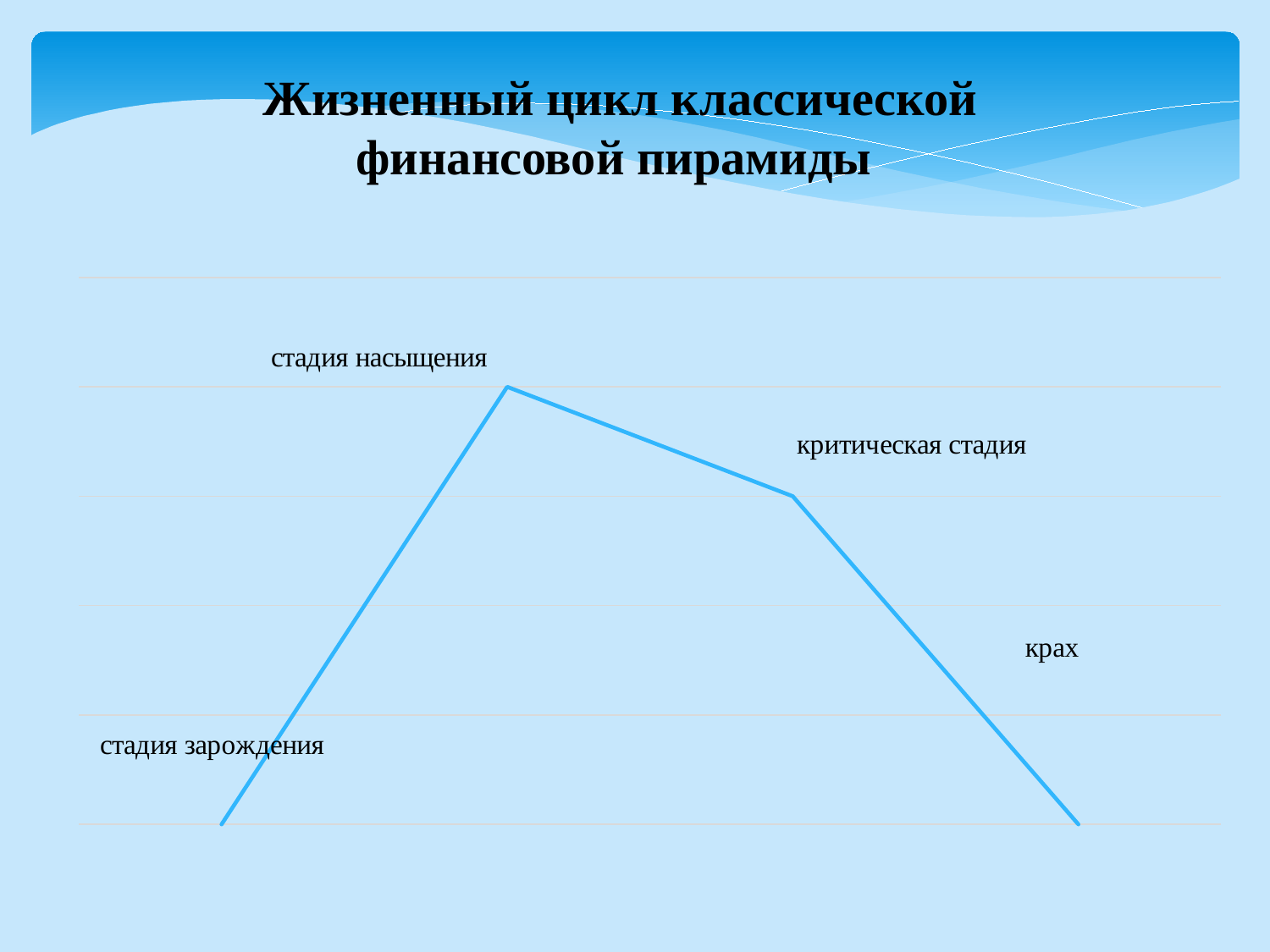
Which is higher on the line, стадия зарождения or стадия насыщения? стадия насыщения Which is higher on the line, стадия насыщения or критическая стадия? стадия насыщения Which is higher on the line, критическая стадия or крах? критическая стадия What kind of chart is shown on the slide? line chart Which labeled stage is at the highest point of the line? стадия насыщения Does the line rise or fall from стадия насыщения to крах? fall How many labeled stages (points) are marked on the line? 4 Does the line rise or fall from стадия зарождения to стадия насыщения? rise What is the title of the chart on the slide? Жизненный цикл классической финансовой пирамиды What is the label of the last stage at the right end of the line? крах